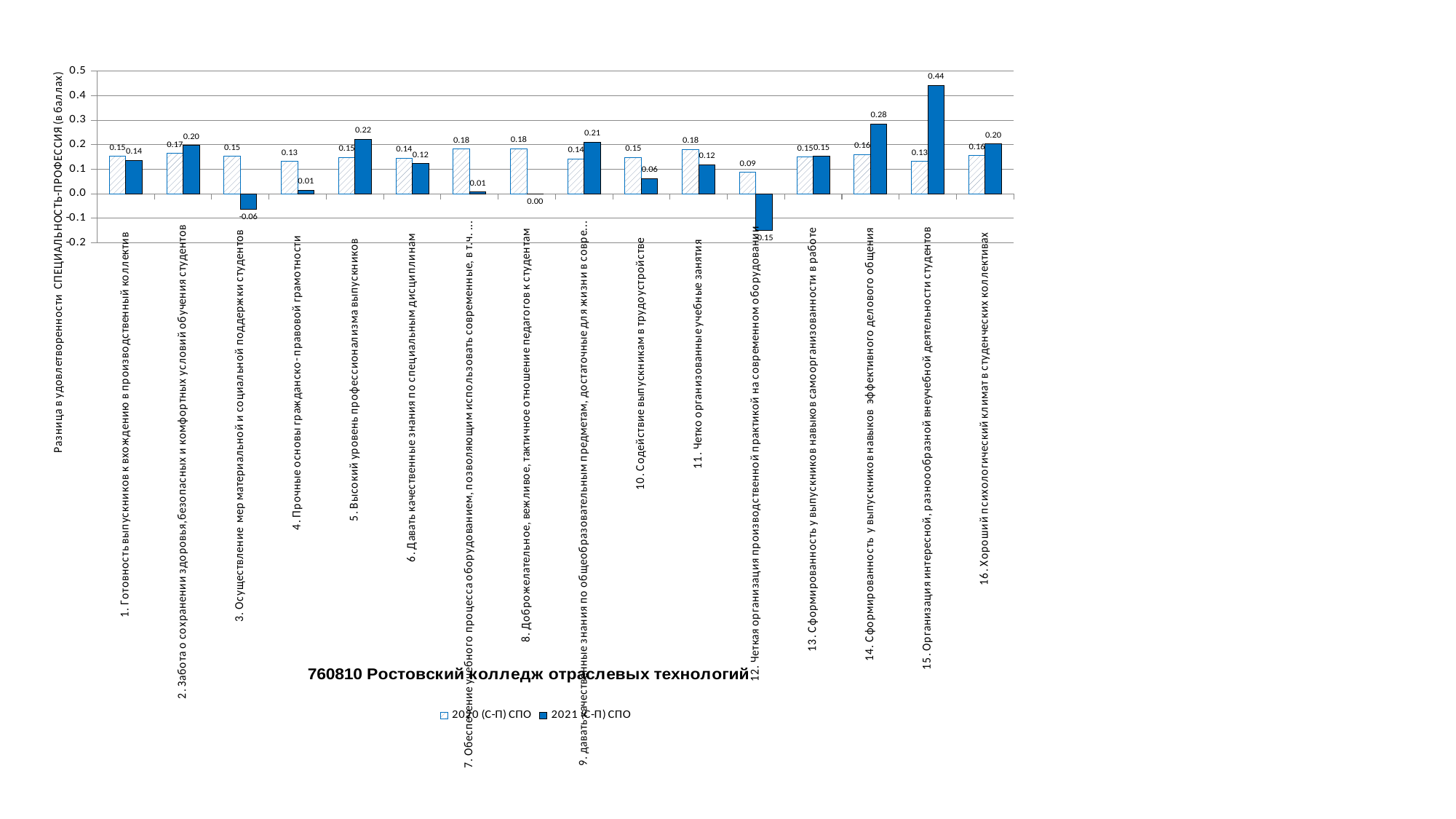
What is the title of the chart? 760810 Ростовский колледж отраслевых технологий Is the 2021 (С-П) СПО value for category 12 greater or less than -0.1? less How many series does the legend list? 2 What is the difference between the 2021 and 2020 values for category 14 (Сформированность у выпускников навыков эффективного делового общения)? 0.12 Which category has the lowest value in the 2020 (С-П) СПО series? 12. Четкая организация производственной практикой на современном оборудовании What is the value of the 2021 (С-П) СПО series for category 3 (Осуществление мер материальной и социальной поддержки студентов)? -0.06 What is the value of the 2020 (С-П) СПО series for category 4 (Прочные основы гражданско-правовой грамотности)? 0.13 Which category has the highest value in the 2021 (С-П) СПО series? 15. Организация интересной, разнообразной внеучебной деятельности студентов How many categories are plotted along the x axis? 16 What is the value of the 2021 (С-П) СПО series for category 15 (Организация интересной, разнообразной внеучебной деятельности студентов)? 0.44 What type of chart is shown on the slide? bar chart For category 7 (Обеспечение учебного процесса оборудованием...), which series has the larger value, 2020 (С-П) СПО or 2021 (С-П) СПО? 2020 (С-П) СПО